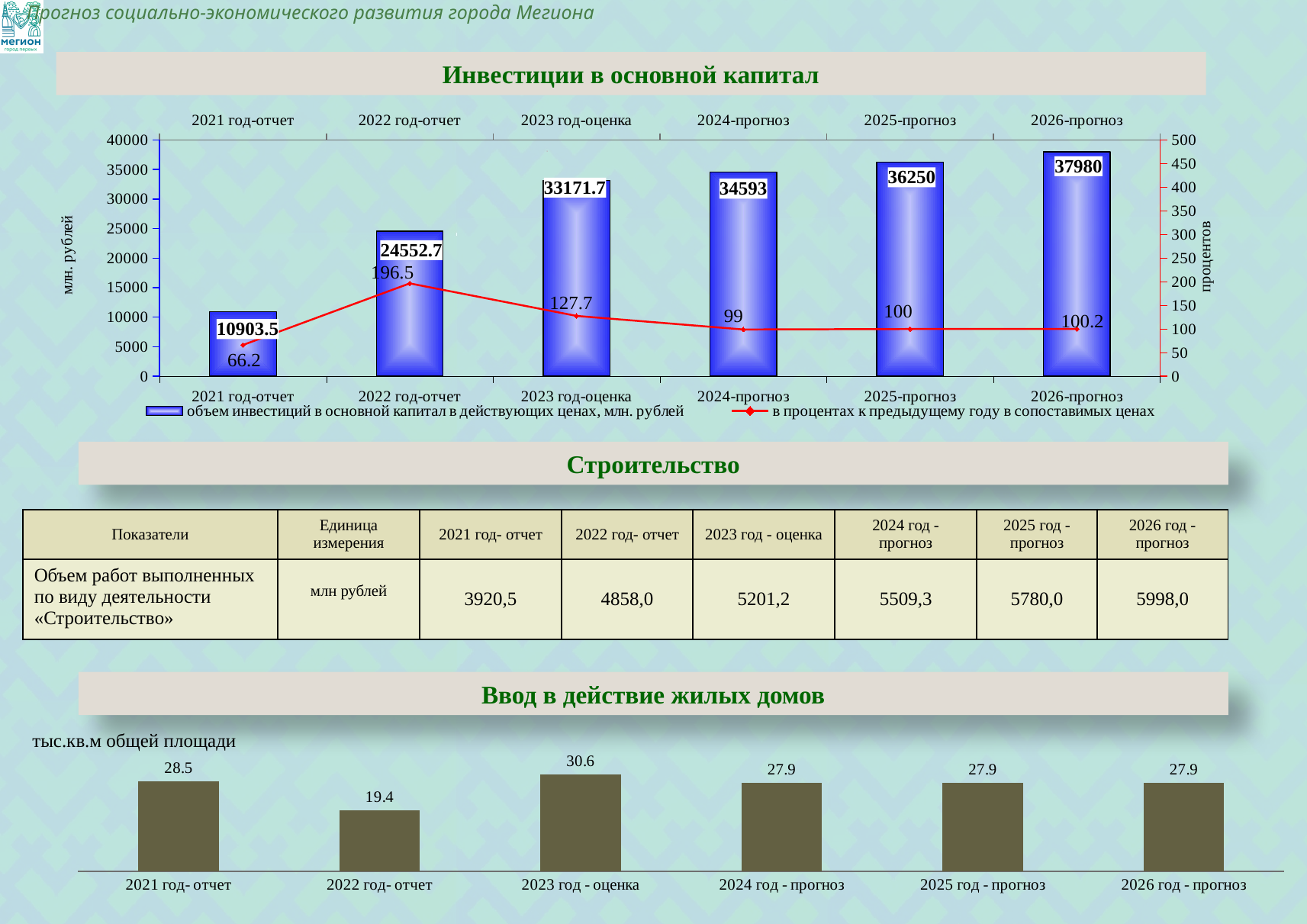
How many series does the legend of the chart 'Инвестиции в основной капитал' list? 2 In the chart 'Инвестиции в основной капитал', which year has the lowest value in percent to the previous year? 2021 год-отчет In the chart 'Инвестиции в основной капитал', which year has the highest volume of investment? 2026-прогноз What kind of chart is 'Ввод в действие жилых домов'? bar chart In the chart 'Ввод в действие жилых домов', which year has the lowest value? 2022 год- отчет In the chart 'Инвестиции в основной капитал', which is larger: the investment volume for 2024-прогноз or for 2025-прогноз? 2025-прогноз In the chart 'Ввод в действие жилых домов', which year has the highest value? 2023 год - оценка In the chart 'Ввод в действие жилых домов', what is the value for 2022 год- отчет? 19.4 In the chart 'Инвестиции в основной капитал', what is the value in percent to the previous year for 2022 год-отчет? 196.5 How many years are shown on the x axis of the chart 'Инвестиции в основной капитал'? 6 In the chart 'Инвестиции в основной капитал', what is the volume of investment in fixed capital for 2023 год-оценка? 33171.7 In the chart 'Инвестиции в основной капитал', what is the difference between the investment volume for 2026-прогноз and 2025-прогноз? 1730